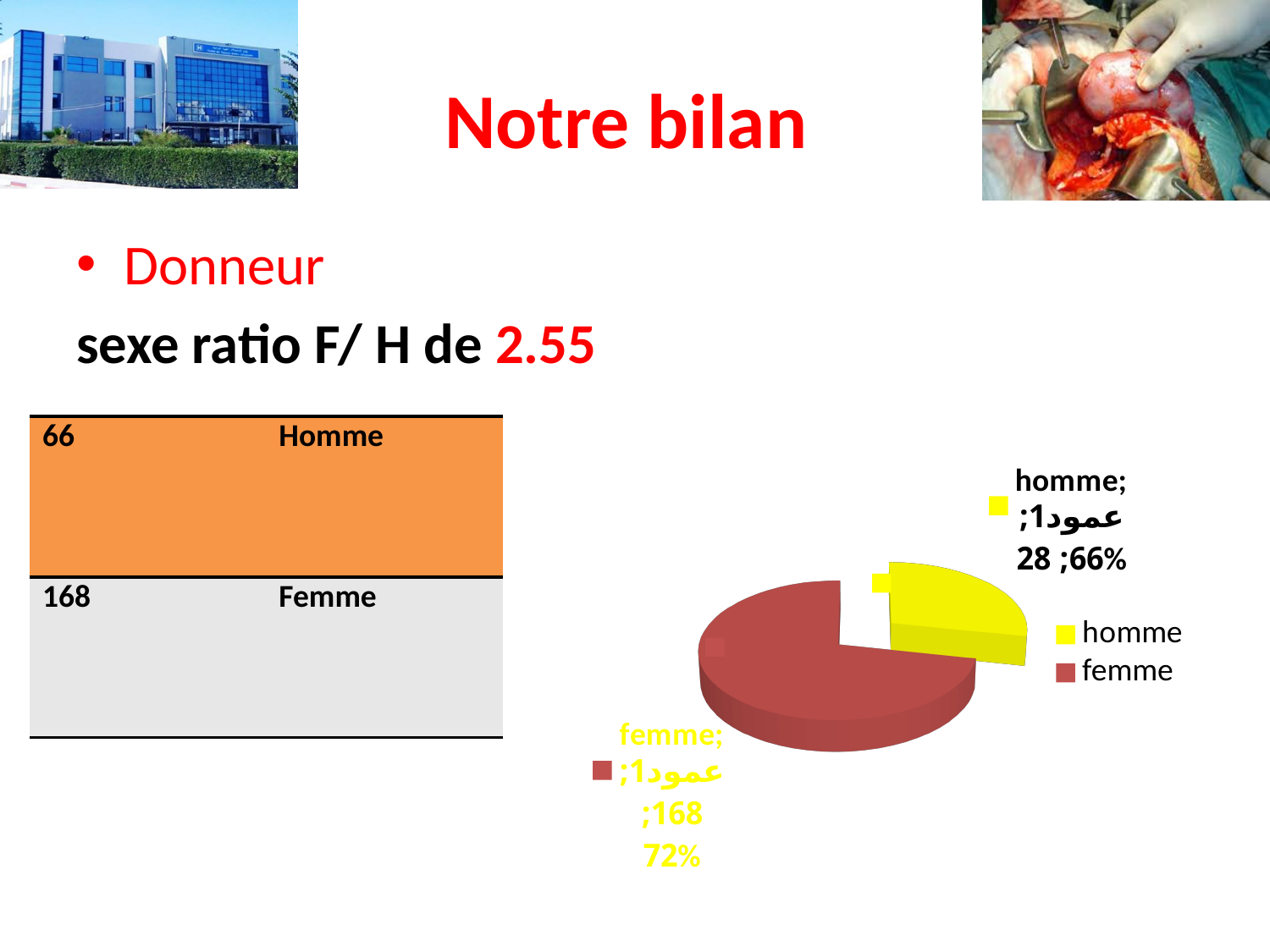
What kind of chart is shown on the slide? pie chart What share of the pie does the femme slice represent? 72% What share of the pie does the homme slice represent? 28% Which is larger in the pie chart, homme or femme? femme Which category has the smallest slice in the pie chart? homme What is the difference between the femme value and the homme value in the pie chart? 102 Which category has the largest slice in the pie chart? femme What colour is the homme slice in the pie chart? yellow What is the value for femme in the pie chart? 168 How many entries does the legend of the pie chart list? 2 What is the value for homme in the pie chart? 66 How many slices does the pie chart have? 2